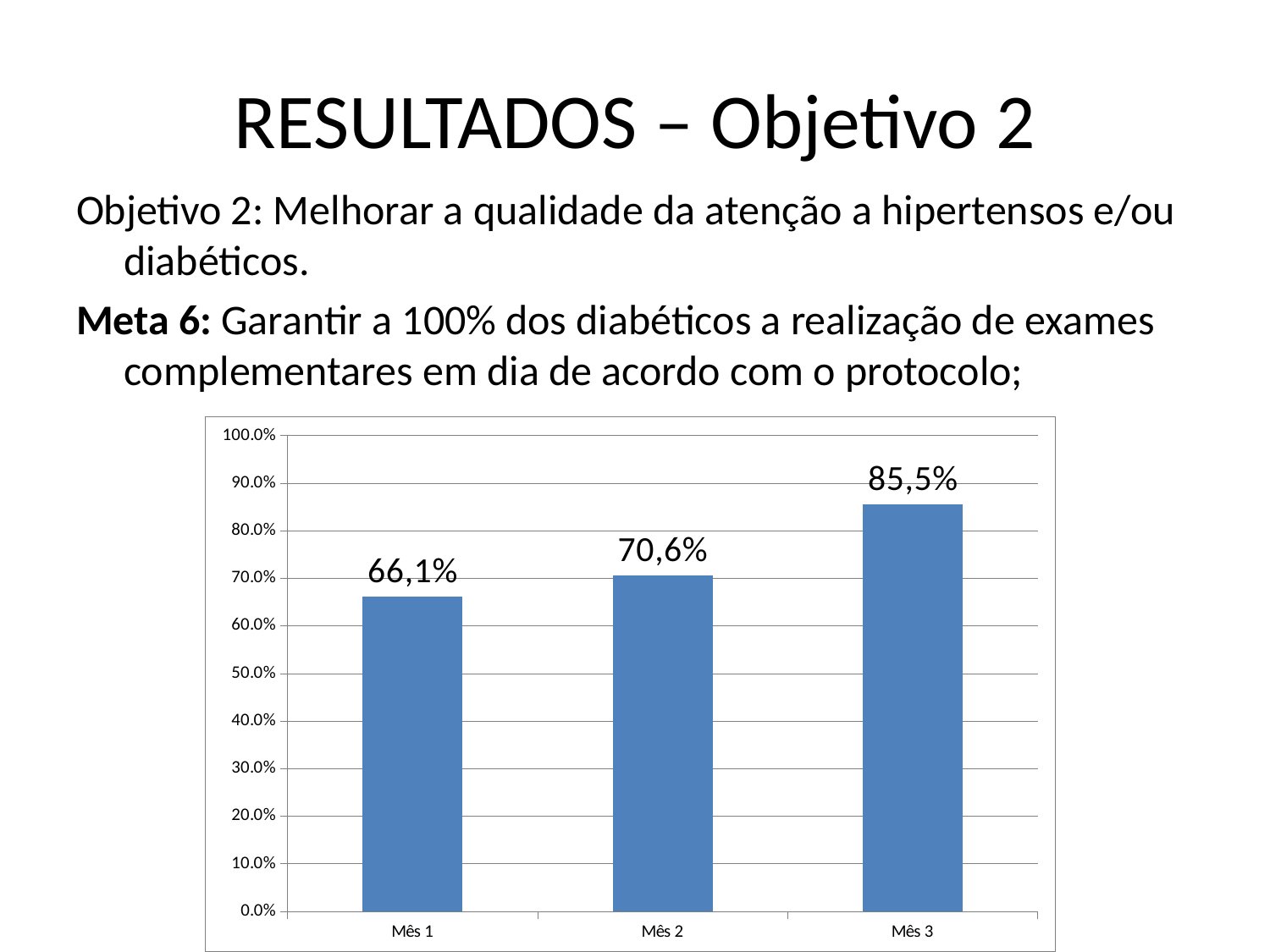
How many months are shown on the chart? 3 Which is larger, the value for Mês 2 or the value for Mês 3? Mês 3 What is the difference between the values for Mês 3 and Mês 1? 19,4% Do the values rise or fall from Mês 1 to Mês 3? rise What is the value for Mês 3? 85,5% Which month has the lowest value? Mês 1 What is the difference between the values for Mês 2 and Mês 1? 4,5% What is the value for Mês 2? 70,6% What kind of chart is shown on the slide? bar chart Is the value for Mês 3 greater or less than 80.0%? greater What is the value for Mês 1? 66,1% Which month has the highest value? Mês 3